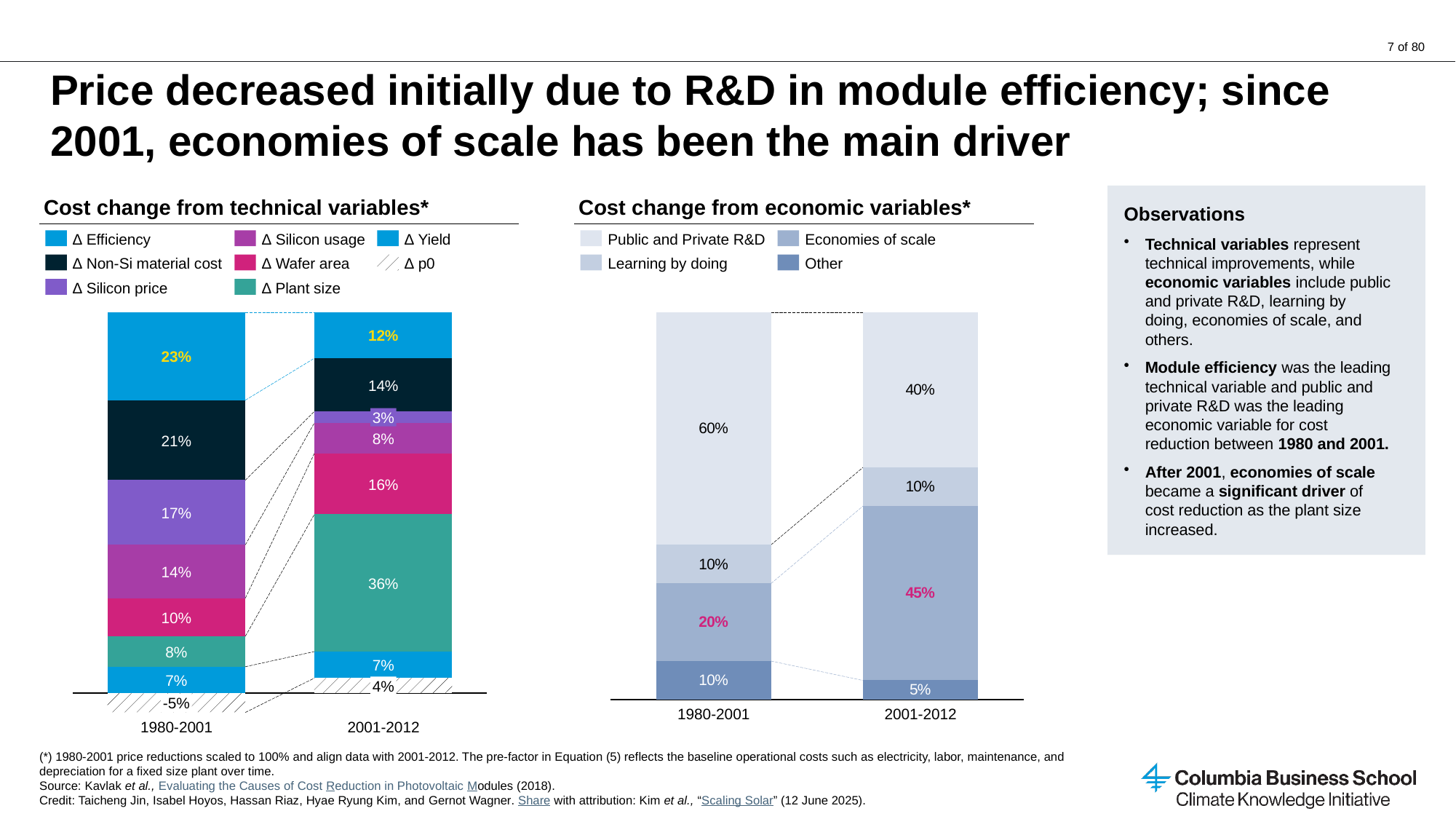
In the 'Cost change from economic variables' chart, what is the total of the 1980-2001 stacked bar? 100% In the 'Cost change from economic variables' chart, what is the value for Economies of scale in 2001-2012? 45% In the 'Cost change from economic variables' chart, by how many percentage points did Public and Private R&D fall from 1980-2001 to 2001-2012? 20 percentage points In the 'Cost change from technical variables' chart, what is the value for Δ Efficiency in 1980-2001? 23% How many series does the legend of the 'Cost change from economic variables' chart list? 4 In the 'Cost change from technical variables' chart, which segment is the largest in the 1980-2001 bar? Δ Efficiency In the 'Cost change from technical variables' chart, what is the value for Δ Plant size in 2001-2012? 36% What kind of chart is the 'Cost change from technical variables' chart? Stacked bar chart In the 'Cost change from economic variables' chart, which segment is the smallest in the 2001-2012 bar? Other In the 'Cost change from economic variables' chart, does the Economies of scale value rise or fall from 1980-2001 to 2001-2012? Rise In the 'Cost change from economic variables' chart, what is the value for Public and Private R&D in 1980-2001? 60% In the 'Cost change from technical variables' chart, is the Δ Wafer area value larger in 1980-2001 or in 2001-2012? 2001-2012